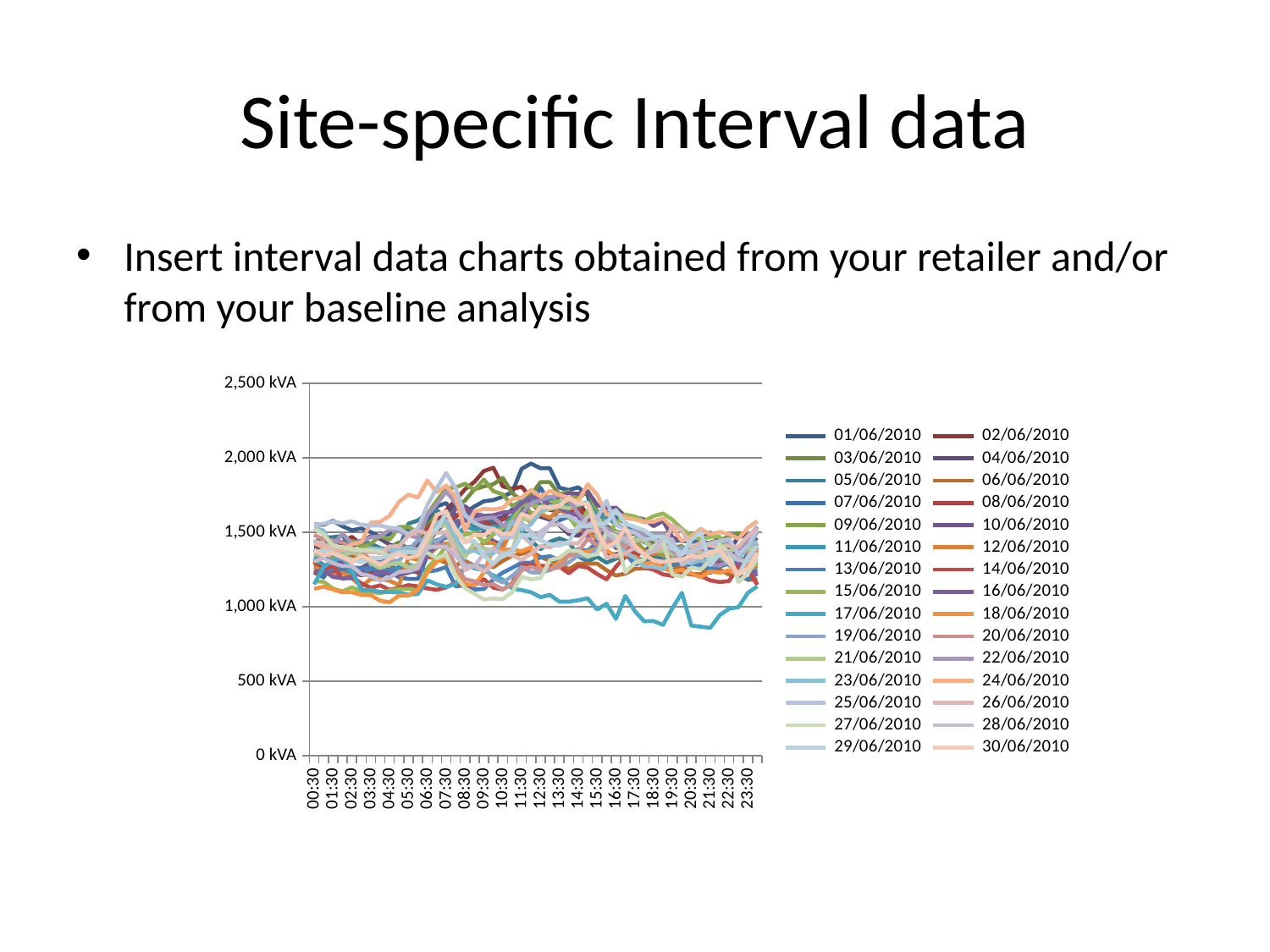
What is the highest value shown on the chart's y axis? 2,500 kVA What is the first time label on the chart's x axis? 00:30 Is the highest point plotted on the chart greater or less than 2,000 kVA? less Is the lowest point plotted on the chart greater or less than 500 kVA? greater What is the first entry in the chart's legend? 01/06/2010 What kind of chart is shown on the slide? line chart How many time labels are shown along the x axis of the chart? 24 How many series does the legend list? 30 What is the last time label on the chart's x axis? 23:30 What is the last entry in the chart's legend? 30/06/2010